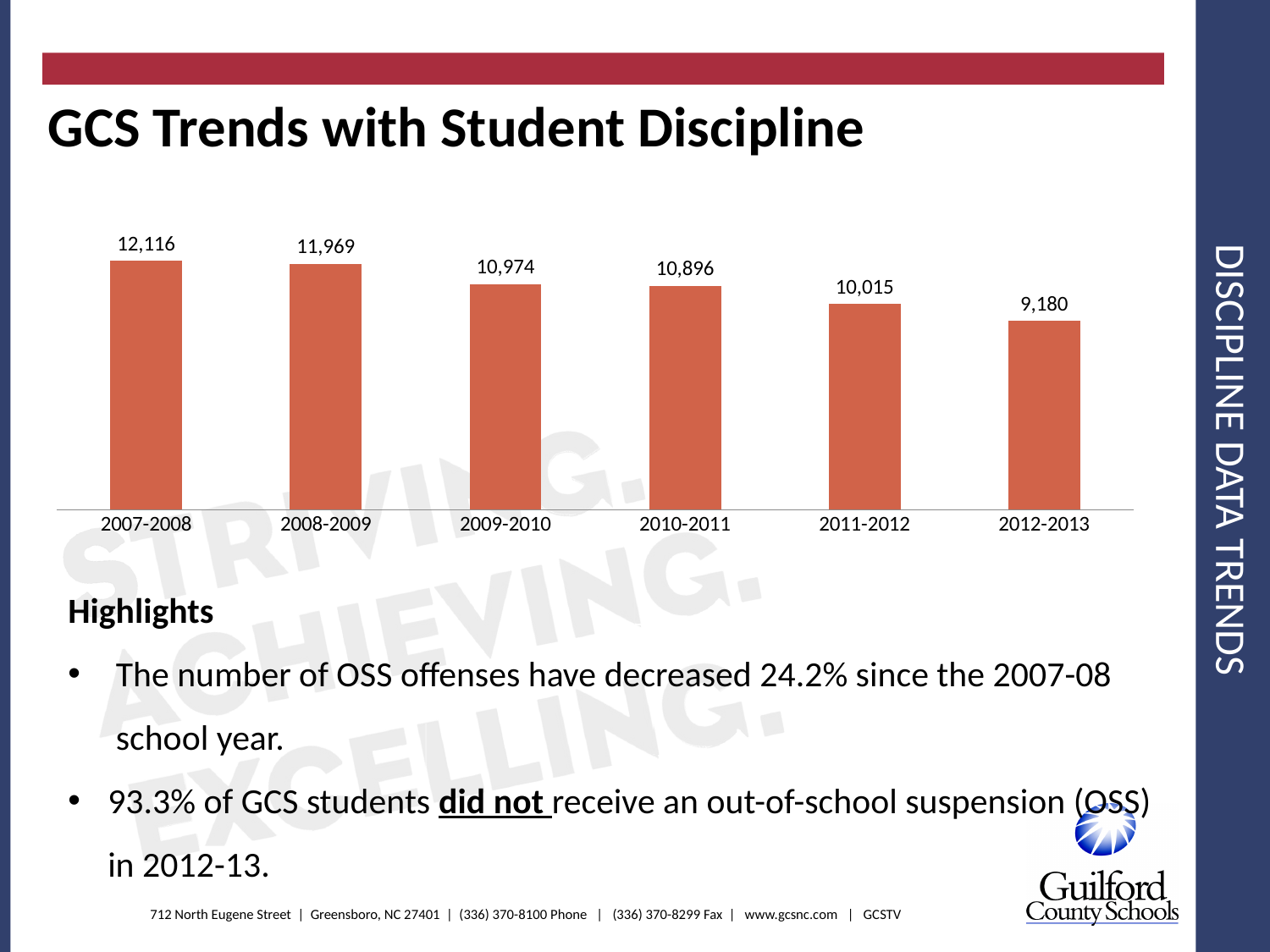
What is the value for 2010-2011? 10,896 Do the values rise or fall from 2007-2008 to 2012-2013? fall Which school year has the lowest value? 2012-2013 How many school years are shown in the chart? 6 What kind of chart is shown on the slide? bar chart What is the difference between the values for 2007-2008 and 2012-2013? 2,936 Which school year has the highest value? 2007-2008 What is the title of the slide containing the chart? GCS Trends with Student Discipline What is the value for 2007-2008? 12,116 Which is larger, the value for 2008-2009 or the value for 2011-2012? 2008-2009 What is the difference between the values for 2009-2010 and 2010-2011? 78 What is the value for 2012-2013? 9,180